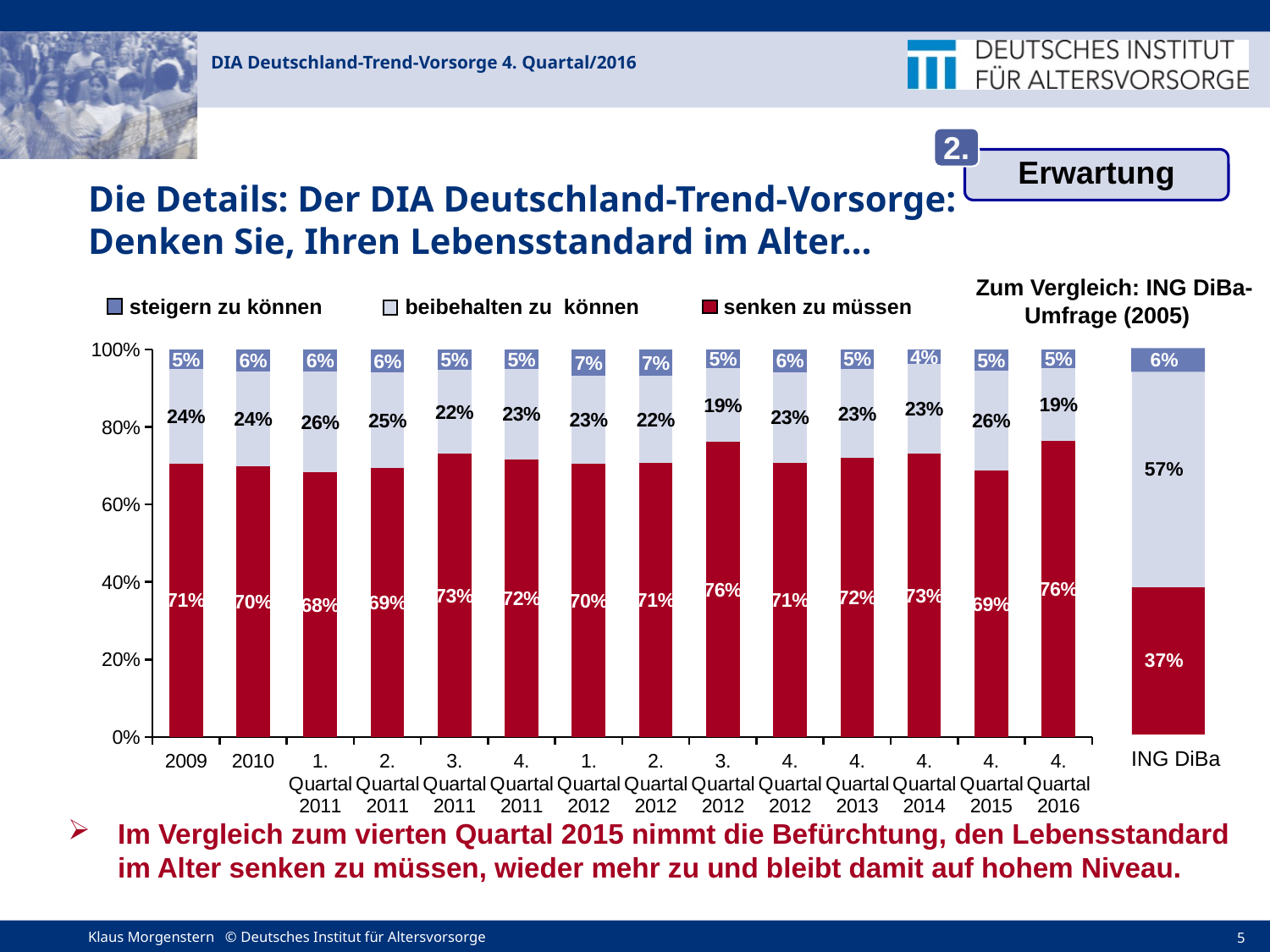
In the main chart, what percentage answered 'beibehalten zu können' in 2009? 24% In the main chart, which category has the lowest value for 'steigern zu können'? 4. Quartal 2014 In the main chart, what percentage answered 'senken zu müssen' in 4. Quartal 2016? 76% What kind of chart is the main chart? Stacked bar chart In the main chart, what percentage answered 'steigern zu können' in 1. Quartal 2012? 7% How many categories are shown on the x axis of the main chart? 14 In the main chart, is the 'senken zu müssen' value larger in 3. Quartal 2011 or in 2. Quartal 2011? 3. Quartal 2011 In the main chart, what is the difference between the 'senken zu müssen' values for 4. Quartal 2016 and 4. Quartal 2015? 7% How many series does the legend of the main chart list? 3 In the comparison chart 'Zum Vergleich: ING DiBa-Umfrage (2005)', what percentage answered 'beibehalten zu können'? 57% In the comparison chart 'Zum Vergleich: ING DiBa-Umfrage (2005)', what percentage answered 'senken zu müssen'? 37% In the main chart, which category has the lowest value for 'senken zu müssen'? 1. Quartal 2011